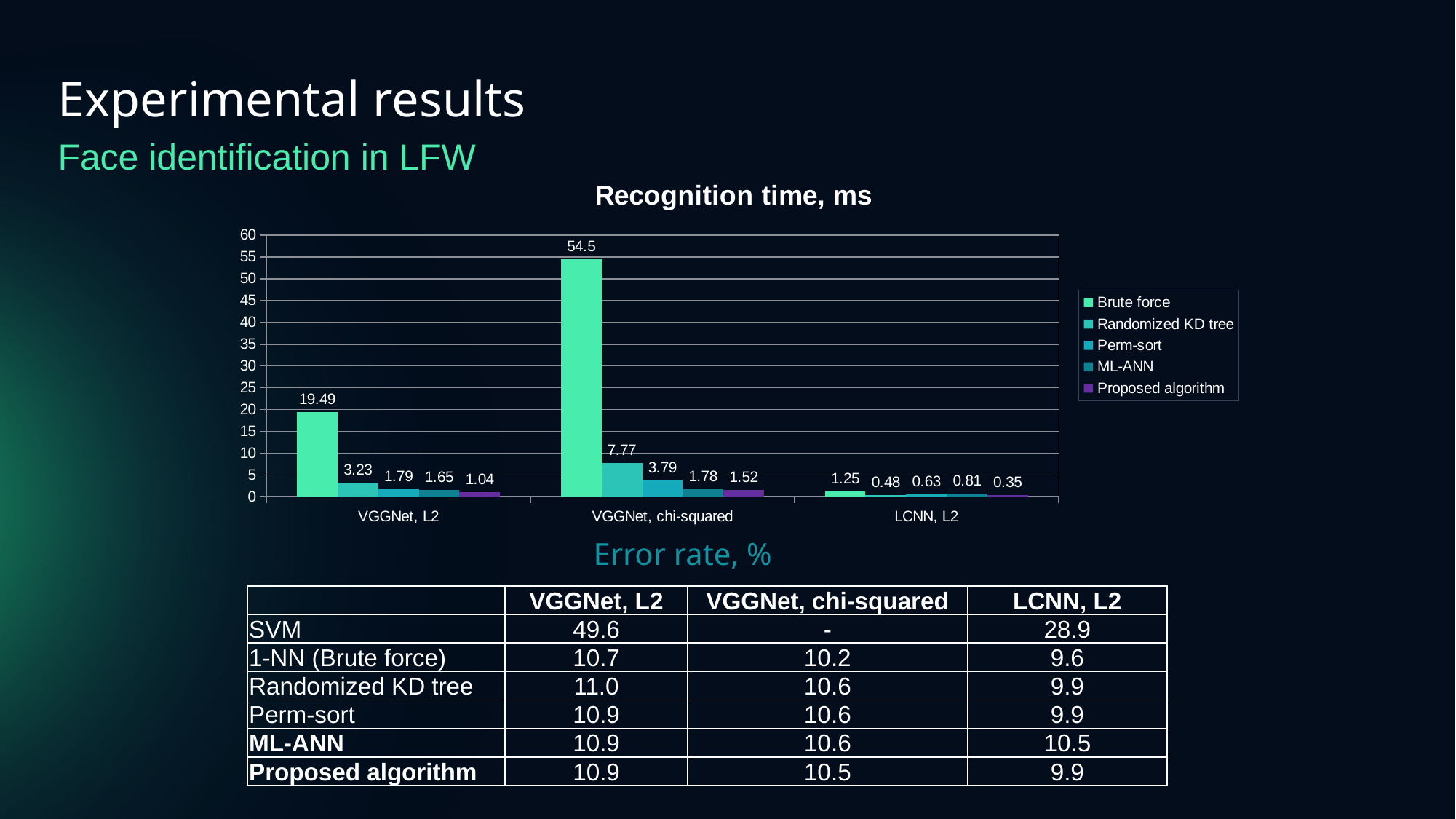
Which series has the lowest recognition time for LCNN, L2? Proposed algorithm What is the recognition time for the Proposed algorithm on VGGNet, L2? 1.04 How many categories are shown on the x axis of the Recognition time chart? 3 Which series has the highest recognition time for VGGNet, L2? Brute force Which has a larger recognition time on VGGNet, chi-squared: Randomized KD tree or Perm-sort? Randomized KD tree What is the difference in recognition time between Brute force and the Proposed algorithm on VGGNet, chi-squared? 52.98 What is the recognition time for Brute force on VGGNet, chi-squared? 54.5 What is the recognition time for Randomized KD tree on LCNN, L2? 0.48 Is the Brute force recognition time for VGGNet, chi-squared greater or less than 50? greater How many series does the legend of the Recognition time chart list? 5 What is the title of the chart on the slide? Recognition time, ms What kind of chart is used to show recognition time? Bar chart